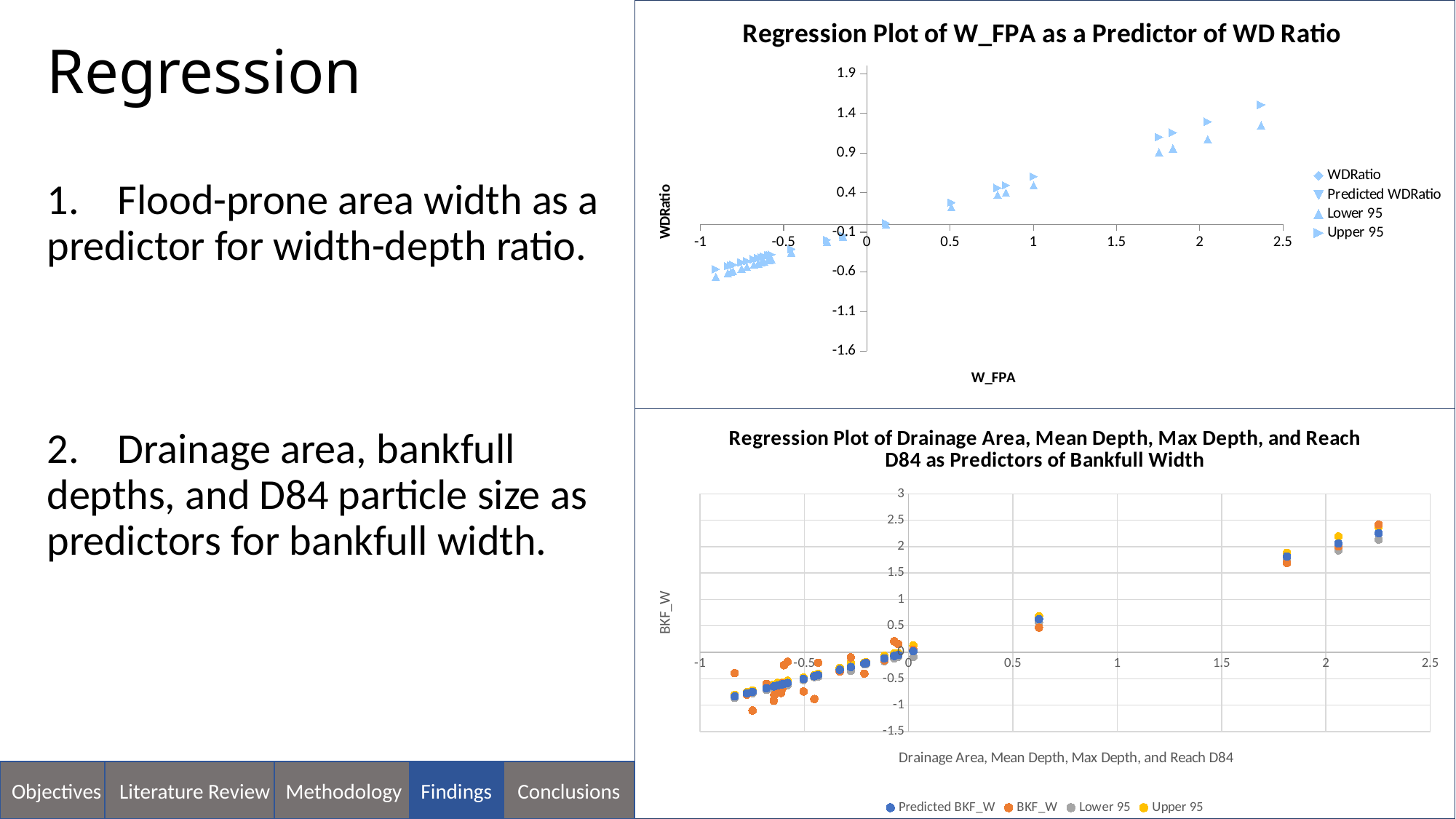
In the top chart, are the values at the leftmost points (around W_FPA -0.9) greater or less than -0.1? less What is the y-axis label of the bottom chart? BKF_W How many series does the legend of the bottom chart list? 4 In the top chart, is the Upper 95 value at the rightmost point (around W_FPA 2.4) greater or less than 0.9? greater In the bottom chart, do the BKF_W values rise or fall as the x-axis values increase? rise How many series does the legend of the top chart list? 4 In the bottom chart, are the values at the point near x = 0.6 greater or less than 1? less In the top chart, do the WDRatio values rise or fall as W_FPA increases along the x axis? rise What kind of chart is the bottom chart, 'Regression Plot of Drainage Area, Mean Depth, Max Depth, and Reach D84 as Predictors of Bankfull Width'? scatter chart What kind of chart is the top chart, 'Regression Plot of W_FPA as a Predictor of WD Ratio'? scatter chart What is the x-axis label of the top chart? W_FPA